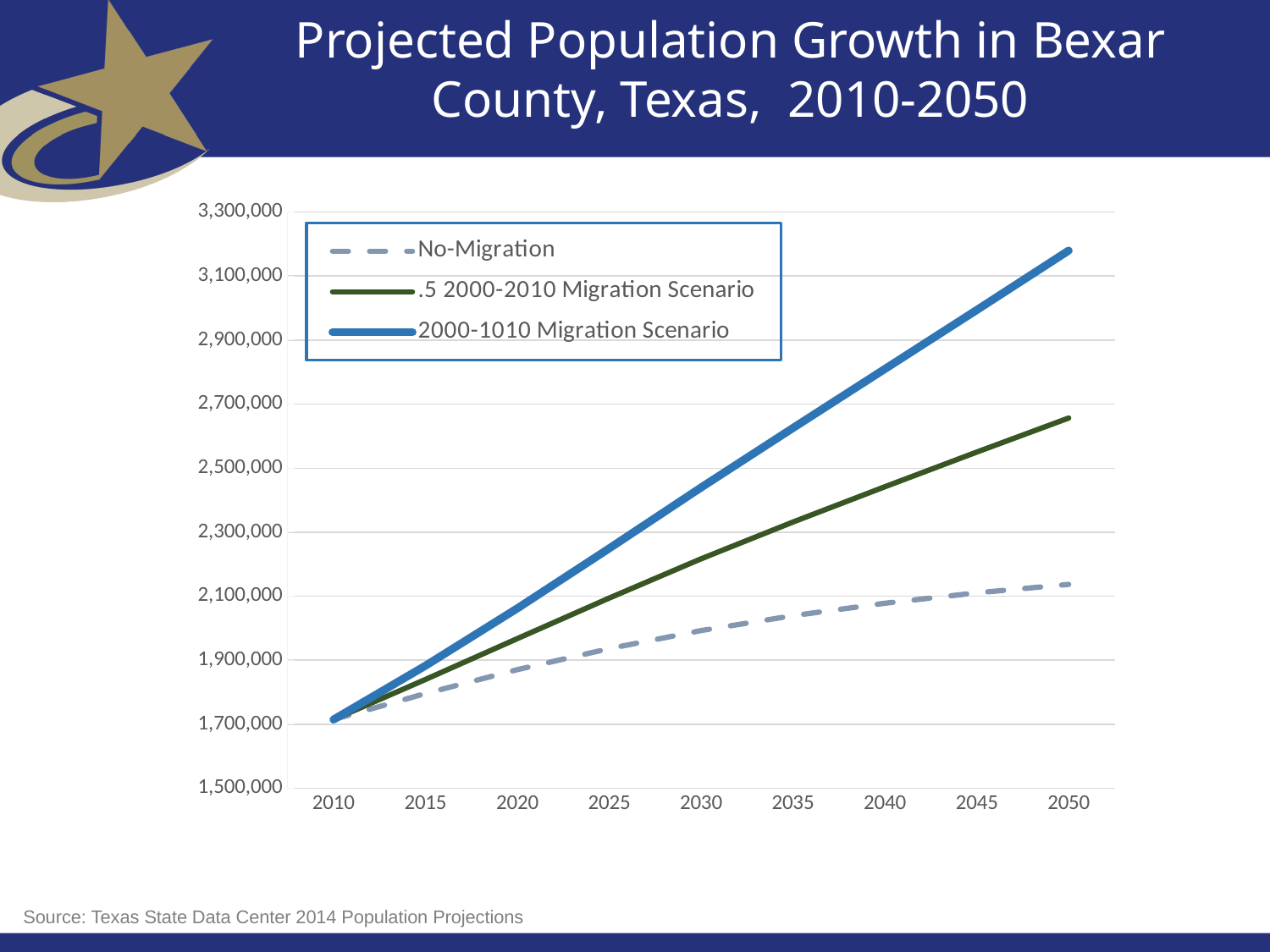
Do the values for the No-Migration series rise or fall from 2010 to 2050? rise Is the 2050 value for the .5 2000-2010 Migration Scenario greater or less than 2,500,000? greater What kind of chart is shown on the slide? line chart Is the 2030 value for the No-Migration series greater or less than 2,100,000? less How many series does the legend list? 3 Is the 2050 value for the No-Migration series greater or less than 2,300,000? less In 2040, which is larger: the .5 2000-2010 Migration Scenario or the No-Migration series? .5 2000-2010 Migration Scenario How many year ticks are shown on the x axis? 9 Which series has the lowest projected population in 2050? No-Migration Which series is drawn with a dashed line? No-Migration Which series has the highest projected population in 2050? 2000-1010 Migration Scenario